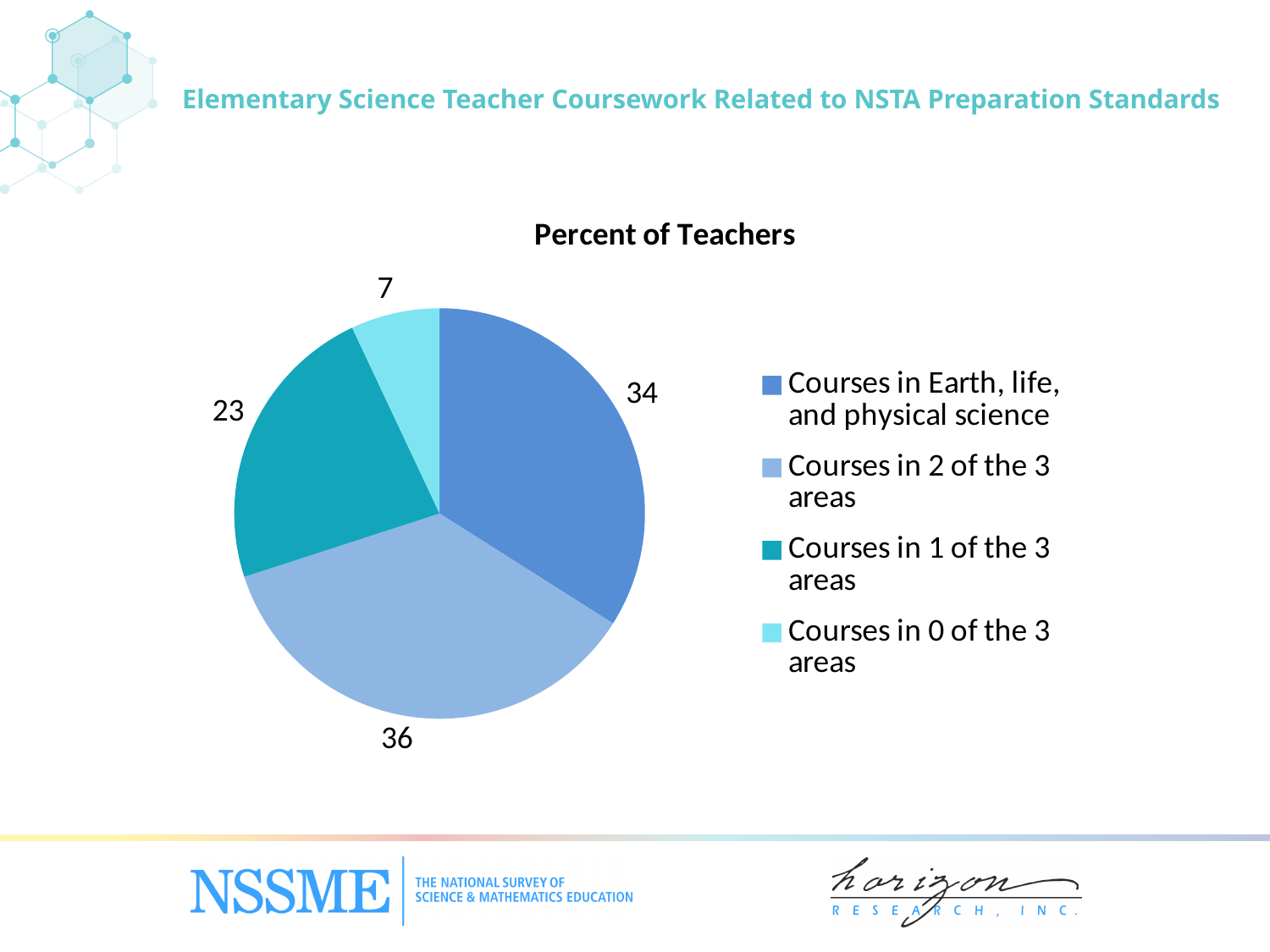
What kind of chart is shown on the slide? pie chart What is the value for 'Courses in Earth, life, and physical science'? 34 What is the title of the chart? Percent of Teachers What is the difference between the values for 'Courses in 2 of the 3 areas' and 'Courses in 1 of the 3 areas'? 13 What is the value for 'Courses in 0 of the 3 areas'? 7 Which category has the largest slice of the pie? Courses in 2 of the 3 areas Which is larger: the value for 'Courses in 1 of the 3 areas' or the value for 'Courses in 0 of the 3 areas'? Courses in 1 of the 3 areas What share of the pie does the 'Courses in 0 of the 3 areas' slice represent? 7% What is the value for 'Courses in 2 of the 3 areas'? 36 Which category has the smallest slice of the pie? Courses in 0 of the 3 areas How many categories does the pie chart have? 4 What is the value for 'Courses in 1 of the 3 areas'? 23